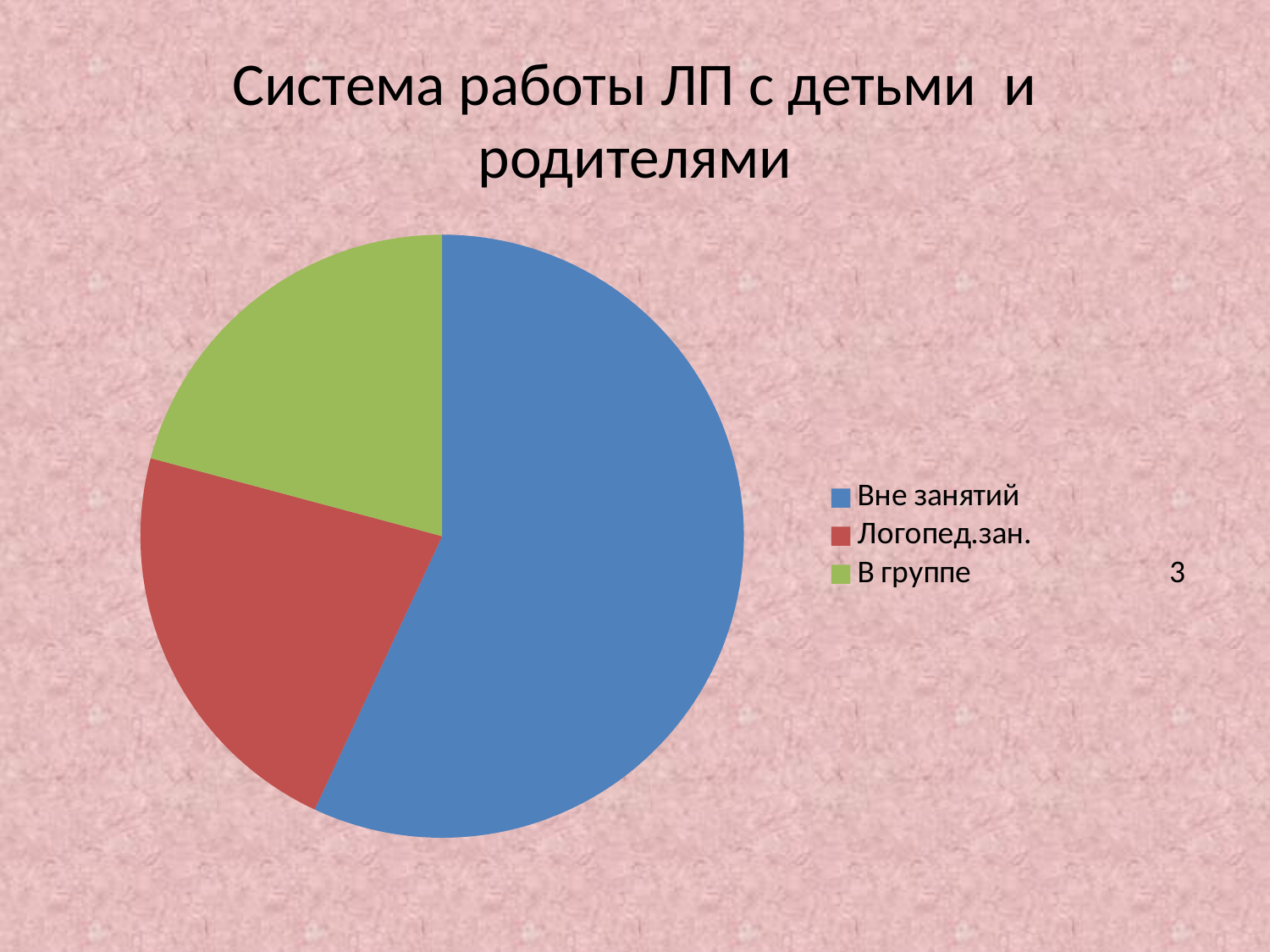
Which slice is larger, Вне занятий or Логопед.зан.? Вне занятий Which slice is larger, Вне занятий or В группе? Вне занятий What colour is the slice for В группе in the pie chart? green How many entries does the legend of the pie chart list? 3 What kind of chart is shown on the slide? pie chart How many slices does the pie chart have? 3 Which category has the largest slice in the pie chart? Вне занятий Does the slice for Вне занятий take up more or less than half of the pie? more What is the title of the slide containing the pie chart? Система работы ЛП с детьми и родителями